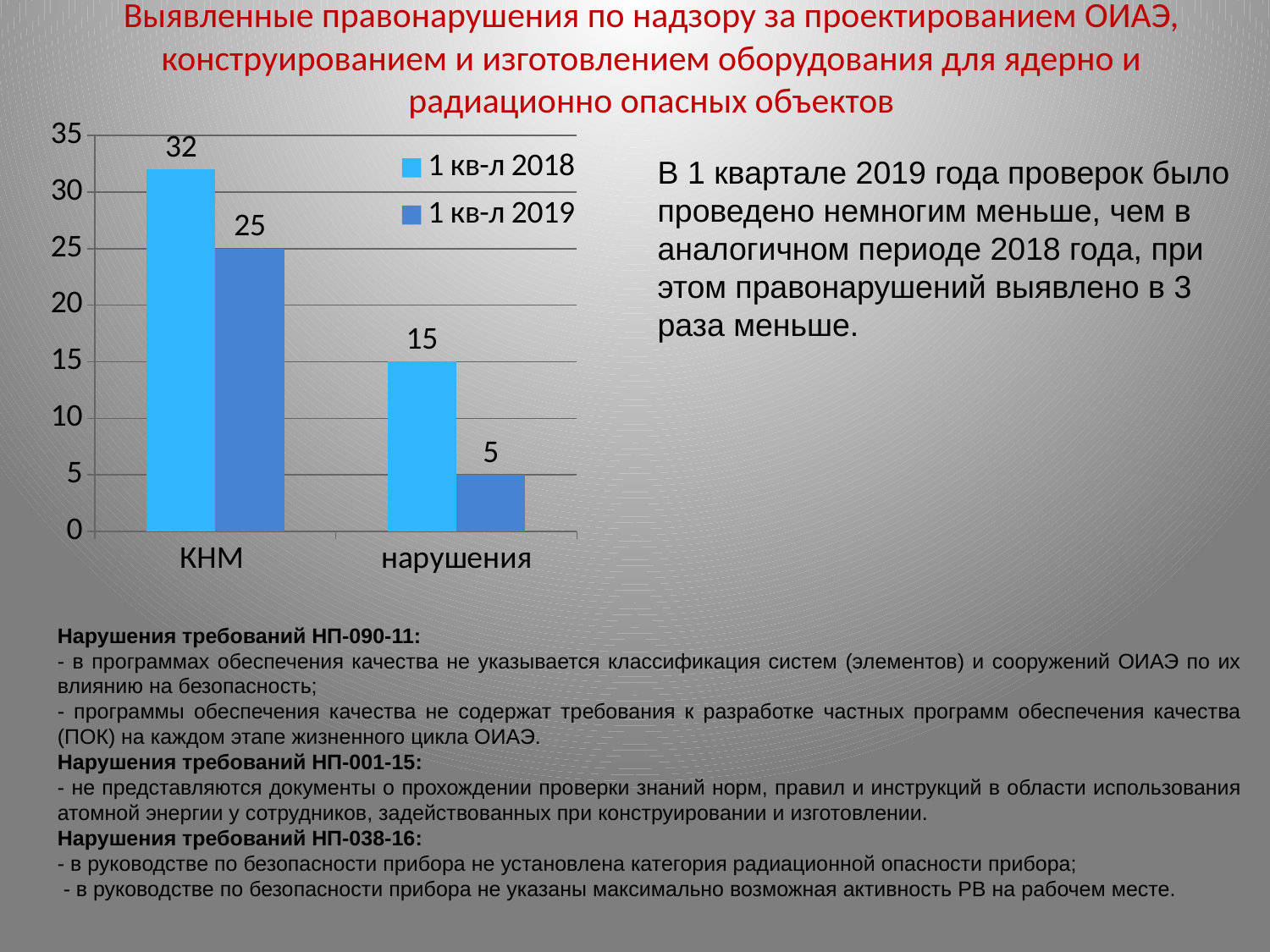
Which category has the highest value in the 1 кв-л 2018 series? КНМ What is the value for нарушения in the 1 кв-л 2019 series? 5 What is the value for КНМ in the 1 кв-л 2018 series? 32 Which is larger: the 1 кв-л 2019 value for КНМ or the 1 кв-л 2018 value for нарушения? 1 кв-л 2019 value for КНМ How many series does the chart legend list? 2 Which category has the lowest value in the 1 кв-л 2019 series? нарушения What is the value for нарушения in the 1 кв-л 2018 series? 15 What is the value for КНМ in the 1 кв-л 2019 series? 25 What is the difference between the 1 кв-л 2018 and 1 кв-л 2019 values for нарушения? 10 What kind of chart is shown on the slide? bar chart How many categories are shown on the x axis of the chart? 2 What is the difference between the 1 кв-л 2018 and 1 кв-л 2019 values for КНМ? 7